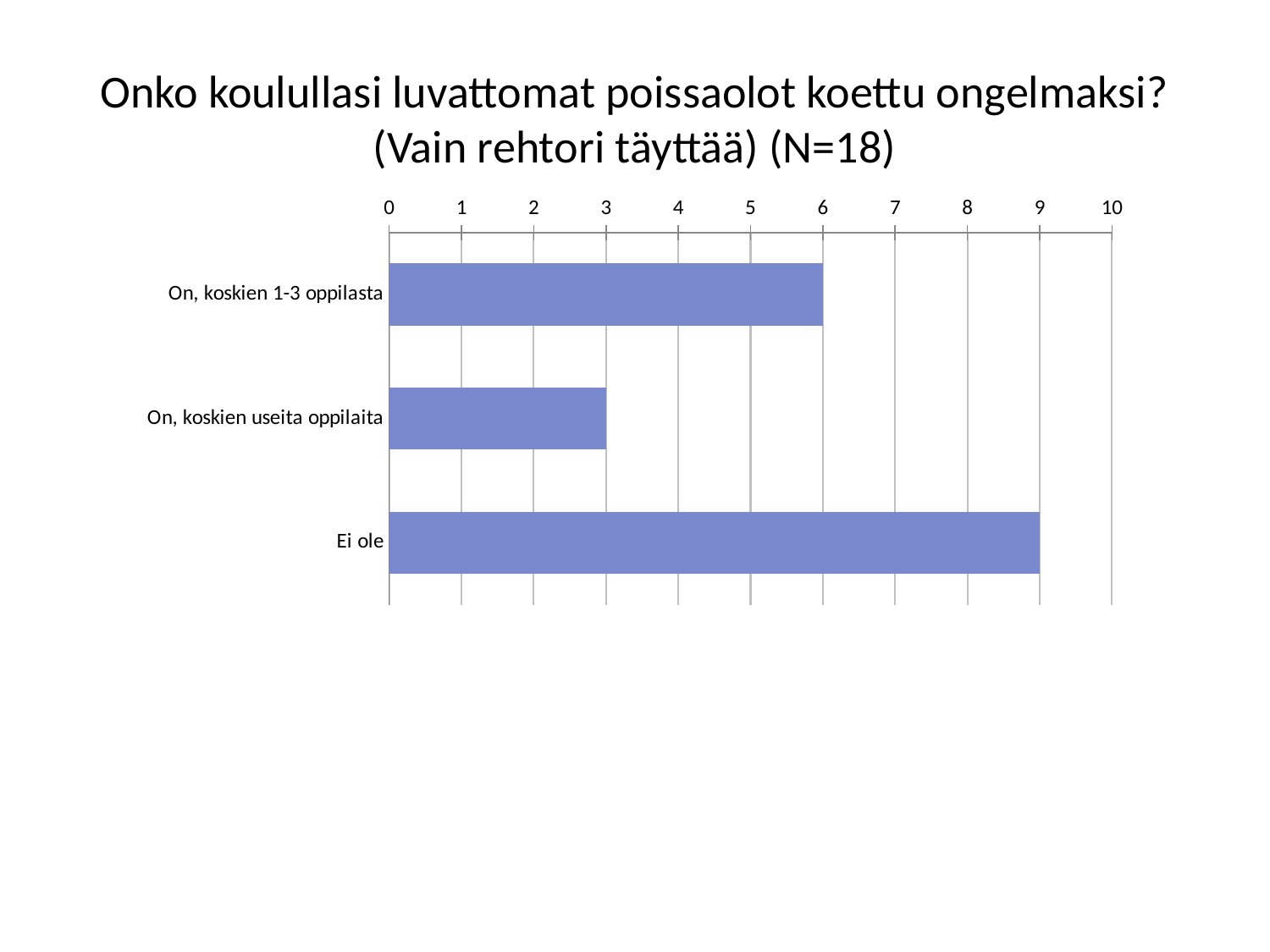
What is the value for "On, koskien useita oppilaita"? 3 How many categories are shown in the chart? 3 Which is larger, the value for "On, koskien 1-3 oppilasta" or the value for "On, koskien useita oppilaita"? On, koskien 1-3 oppilasta Which category has the highest value? Ei ole Which category has the lowest value? On, koskien useita oppilaita What kind of chart is shown on the slide? bar chart What is the value for "On, koskien 1-3 oppilasta"? 6 What is the value for "Ei ole"? 9 What is the maximum value shown on the horizontal axis? 10 Is the value for "Ei ole" greater or less than 5? greater What is the difference between the values for "Ei ole" and "On, koskien 1-3 oppilasta"? 3 What is the difference between the values for "On, koskien 1-3 oppilasta" and "On, koskien useita oppilaita"? 3